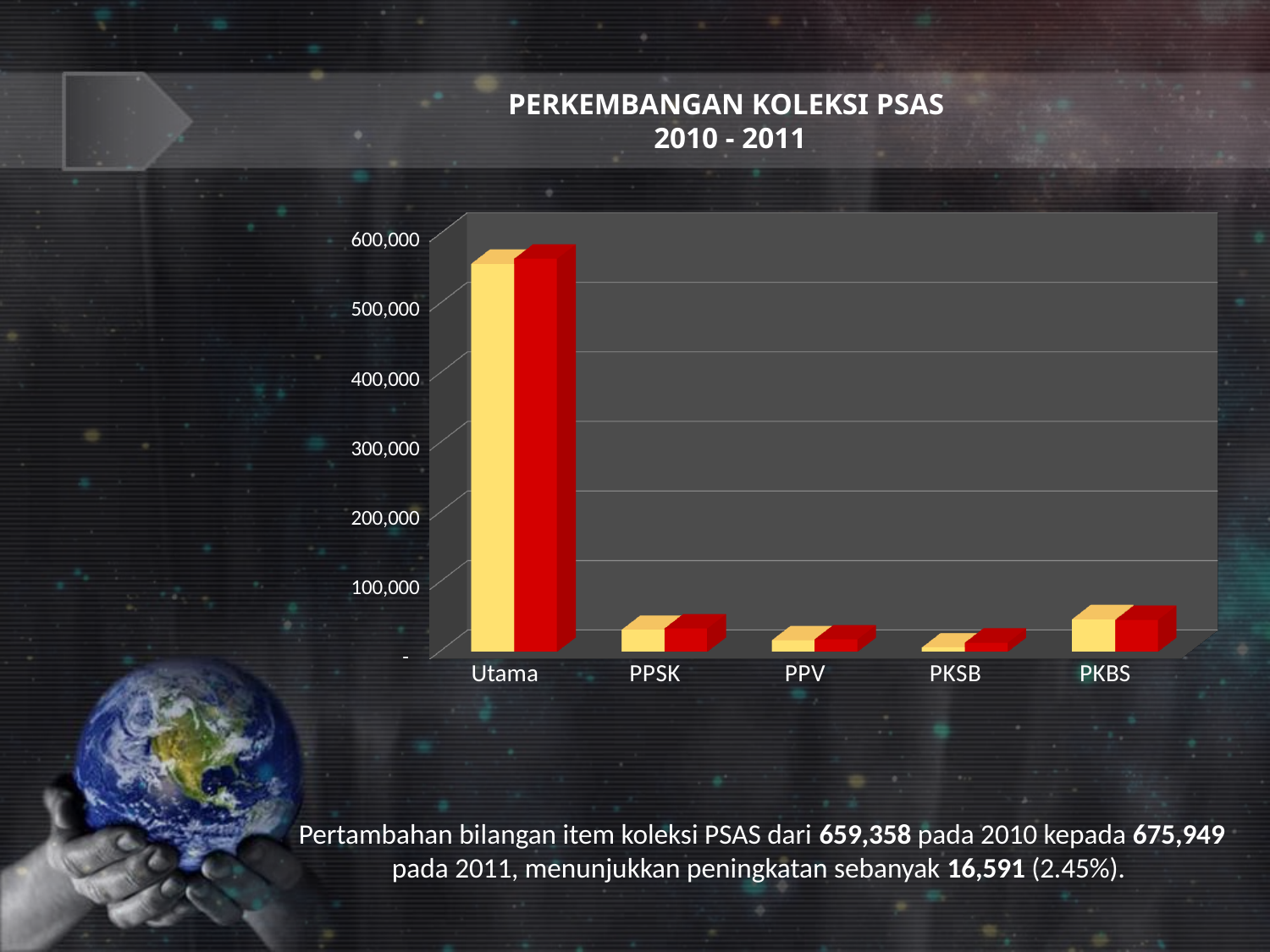
How many categories are shown on the x axis of the chart? 5 Is the value for Utama greater or less than 500,000? greater Is the value for PPSK greater or less than 100,000? less Which category has the highest values in the chart? Utama Which category has larger values, PPSK or PKSB? PPSK What is the title of the chart? PERKEMBANGAN KOLEKSI PSAS 2010 - 2011 Is the value for PKBS greater or less than 200,000? less Which category has the lowest values in the chart? PKSB How many bars are plotted for each category in the chart? 2 Which category has larger values, PKBS or PPV? PKBS What kind of chart is shown on the slide? bar chart Which category has larger values, Utama or PKBS? Utama